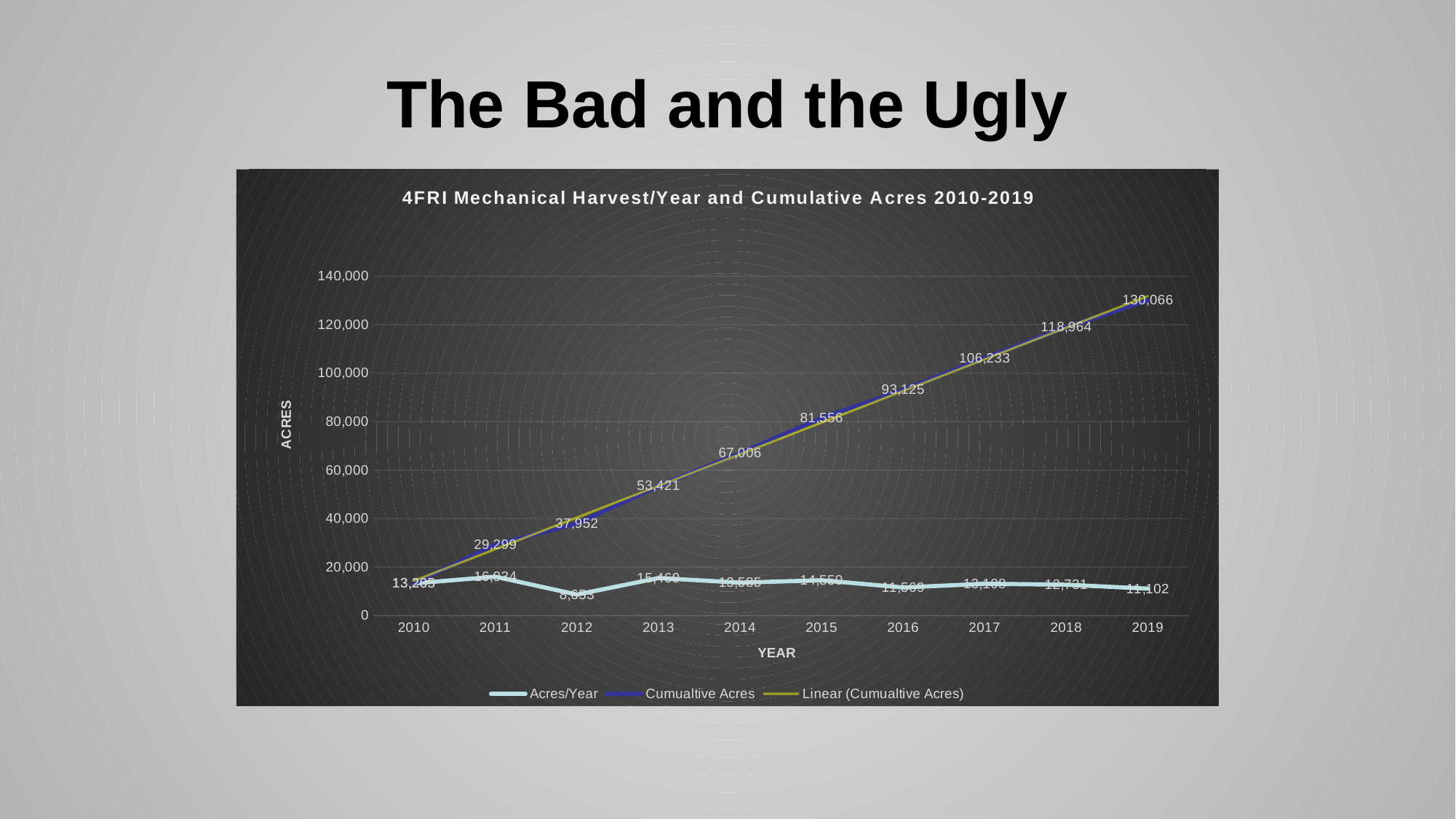
Which year has the lowest Acres/Year value? 2012 Do the Cumulative Acres values rise or fall from 2010 to 2019? rise What is the Cumulative Acres value for 2019? 130,066 What is the difference between the Cumulative Acres values for 2019 and 2018? 11,102 How many years are shown on the x axis? 10 Which year has the larger Cumulative Acres value, 2016 or 2017? 2017 Is the Cumulative Acres value for 2014 greater or less than 60,000? greater What is the Acres/Year value for 2012? 8,653 What is the Cumulative Acres value for 2015? 81,556 Which year has the highest Acres/Year value? 2011 How many series does the legend list? 3 What kind of chart is shown on the slide? line chart